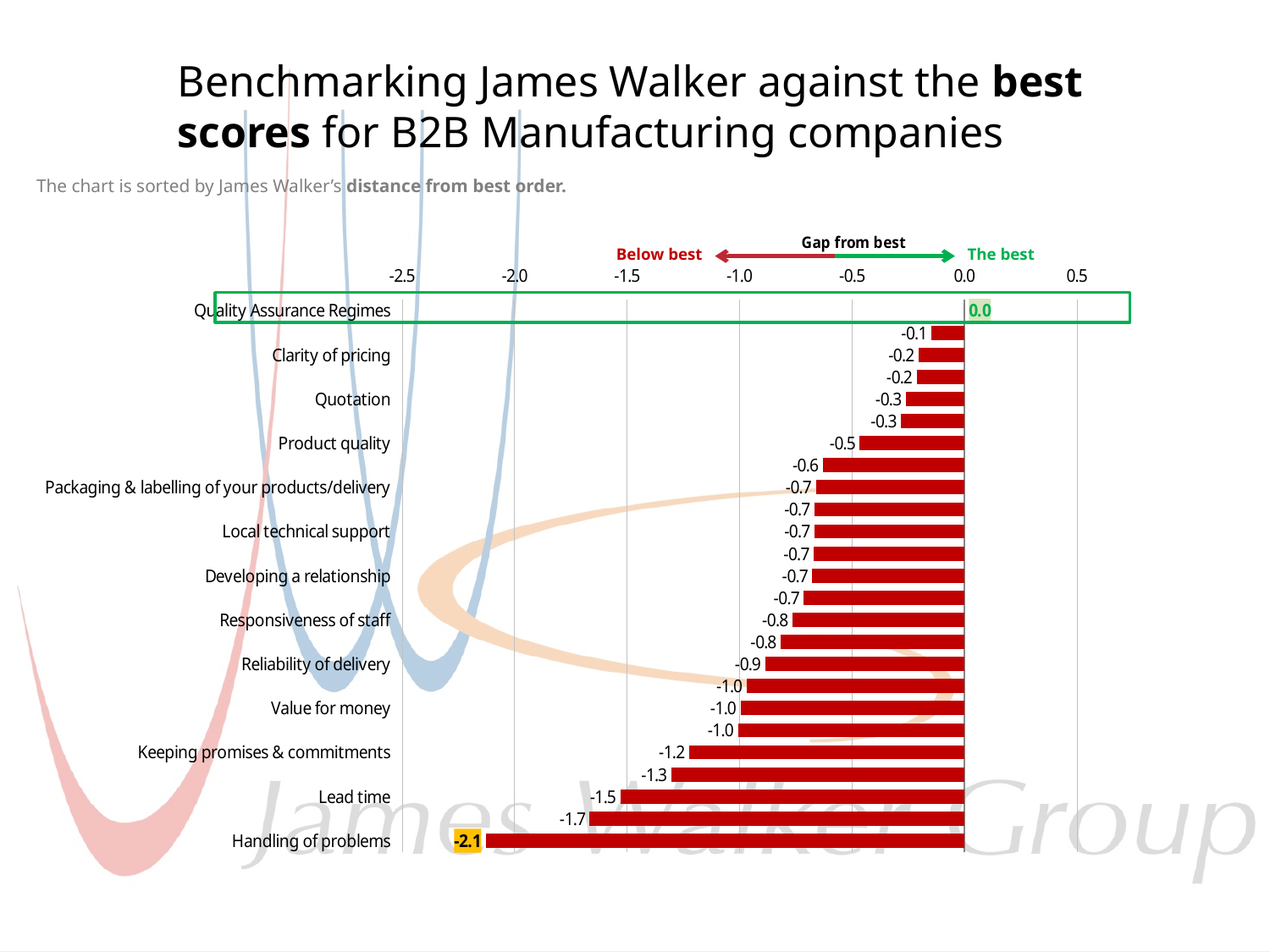
What is the difference between the values for Lead time and Handling of problems? 0.6 What is the value for Value for money? -1.0 What is the value for Quality Assurance Regimes? 0.0 Which has a larger value, Clarity of pricing or Keeping promises & commitments? Clarity of pricing What type of chart is shown on the slide? bar chart What is the value for Product quality? -0.5 What label appears at the right end of the 'Gap from best' arrow above the chart? The best Which category has the highest value? Quality Assurance Regimes Is the value for Reliability of delivery greater or less than -0.5? less What is the value for Lead time? -1.5 Which category has the lowest value (furthest below best)? Handling of problems What is the value for Handling of problems? -2.1